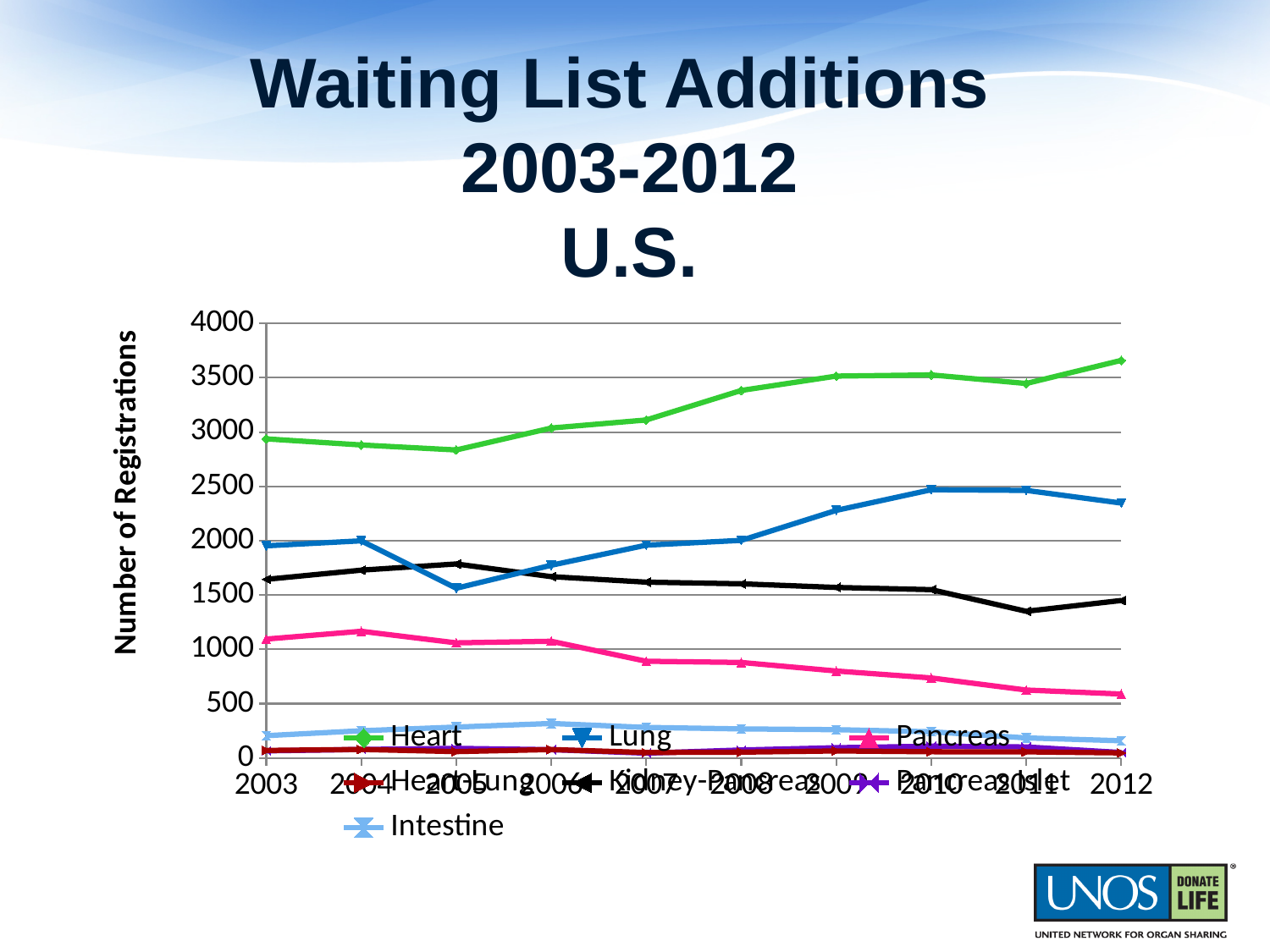
What is the label of the y axis? Number of Registrations What kind of chart is shown on the slide? line chart Does the Pancreas series rise or fall from 2003 to 2012? fall In which year does the Heart series reach its highest value? 2012 In 2012, which is larger: Lung or Kidney-Pancreas? Lung Is the value for Kidney-Pancreas in 2011 greater or less than 1500? less Is the value for Pancreas in 2012 greater or less than 500? greater Is the value for Heart in 2012 greater or less than 3500? greater How many years are plotted along the x axis? 10 Which series has the highest number of registrations across the chart? Heart How many series does the legend list? 7